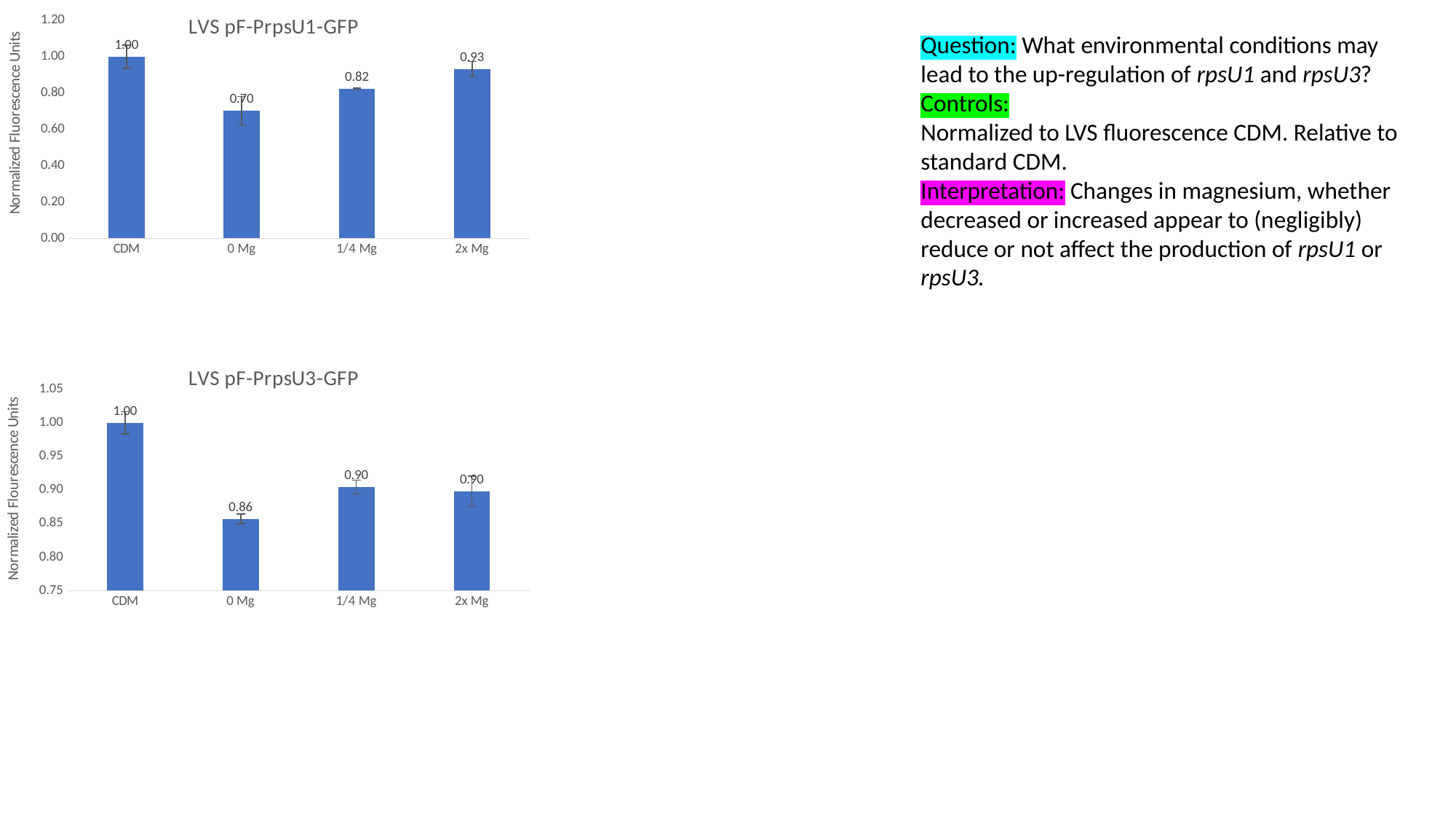
How many categories are shown in the LVS pF-PrpsU3-GFP chart? 4 In the LVS pF-PrpsU3-GFP chart, what is the difference between the 1/4 Mg value and the 0 Mg value? 0.04 In the LVS pF-PrpsU3-GFP chart, what is the value for 0 Mg? 0.86 In the LVS pF-PrpsU3-GFP chart, what is the value for 1/4 Mg? 0.90 In the LVS pF-PrpsU1-GFP chart, what is the value for 2x Mg? 0.93 What is the y-axis label of the LVS pF-PrpsU3-GFP chart? Normalized Flourescence Units In the LVS pF-PrpsU1-GFP chart, which category has the lowest value? 0 Mg What kind of chart is the LVS pF-PrpsU1-GFP chart? Bar chart In the LVS pF-PrpsU3-GFP chart, which category has the highest value? CDM In the LVS pF-PrpsU1-GFP chart, what is the value for 0 Mg? 0.70 In the LVS pF-PrpsU1-GFP chart, which is larger, the value for 1/4 Mg or the value for 2x Mg? 2x Mg In the LVS pF-PrpsU1-GFP chart, what is the difference between the CDM value and the 0 Mg value? 0.30